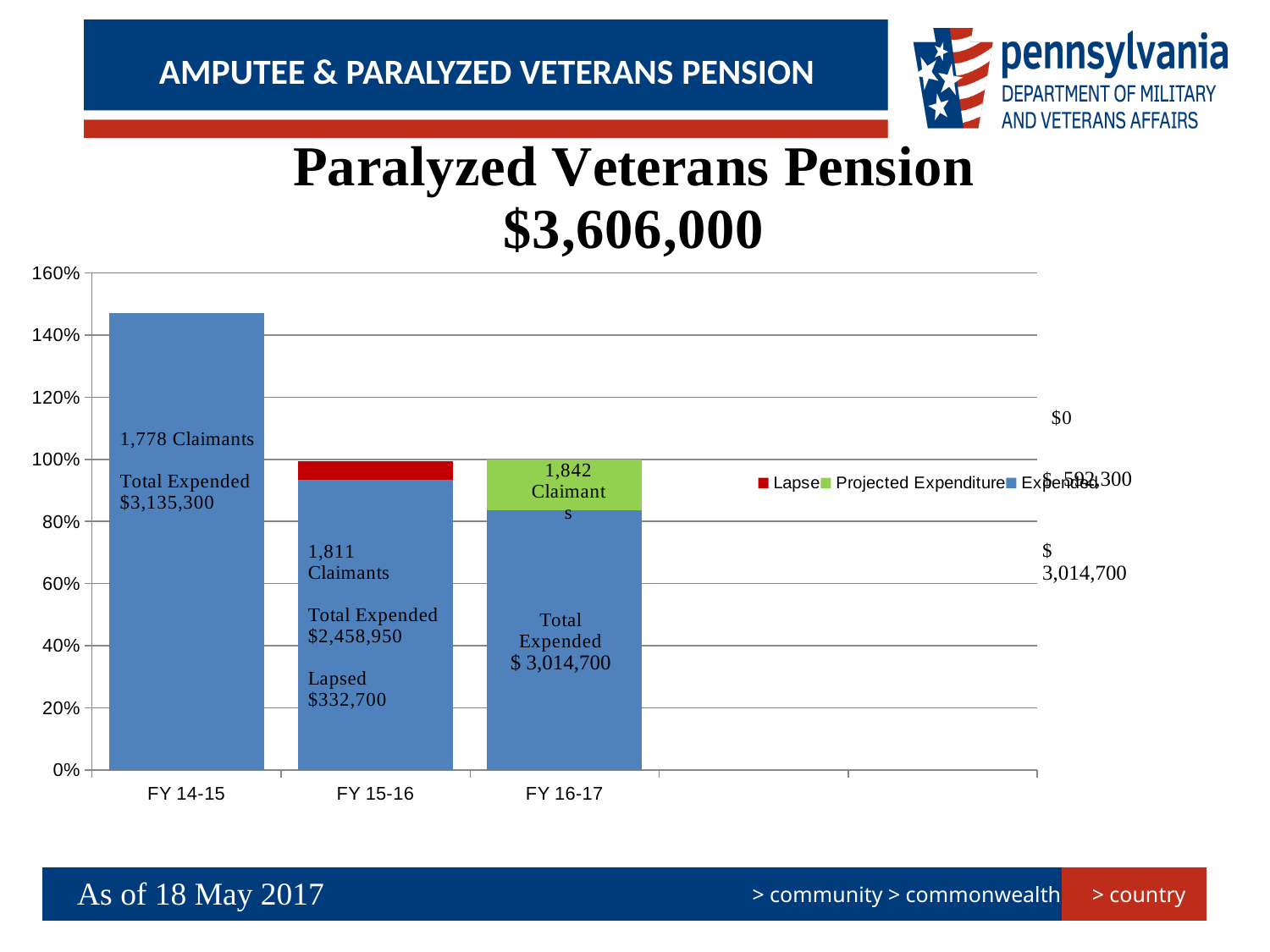
How many series does the chart legend list? 3 How many claimants are shown for FY 15-16? 1,811 What is the Total Expended amount shown for FY 16-17? $3,014,700 What is the Total Expended amount shown for FY 14-15? $3,135,300 Which fiscal year has more claimants, FY 14-15 or FY 16-17? FY 16-17 What is the difference between the Total Expended for FY 14-15 and FY 15-16? $676,350 Is the bar for FY 14-15 greater or less than 140%? greater What kind of chart is shown on the slide? bar chart Which legend entry is shown in red? Lapse What is the Lapsed amount shown for FY 15-16? $332,700 How many fiscal years are shown on the x axis of the chart? 3 Which fiscal year has the tallest bar in the chart? FY 14-15